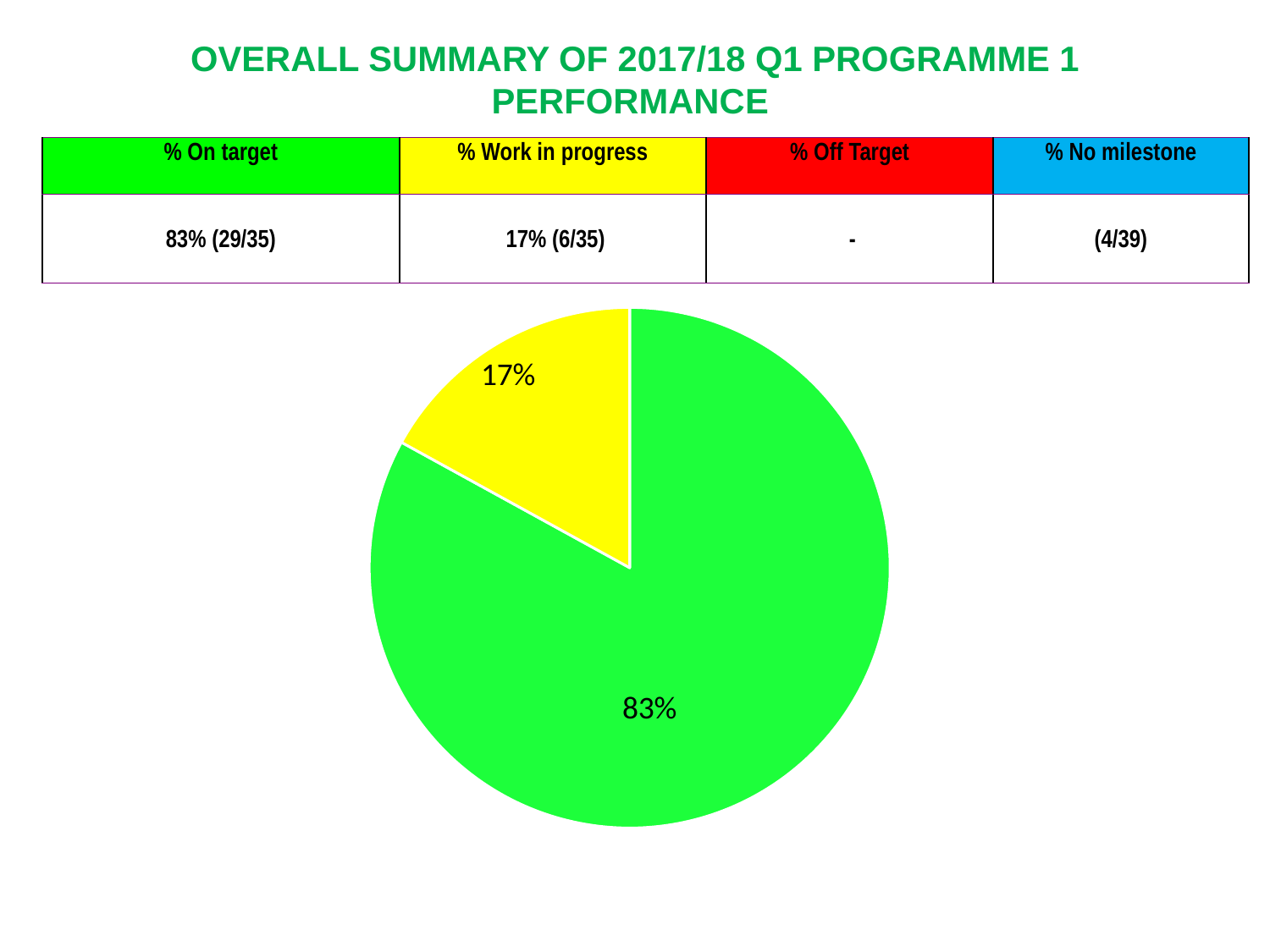
Which slice of the pie chart is the smallest? the yellow slice (17%) Using the colour key in the table above the pie chart, which category does the yellow slice represent? % Work in progress What kind of chart is shown on the slide? pie chart What is the difference in percentage points between the green slice and the yellow slice of the pie chart? 66 What share of the pie does the yellow slice represent? 17% What percentage is shown on the green slice of the pie chart? 83% Which is larger in the pie chart, the green slice or the yellow slice? the green slice Which slice of the pie chart is the largest? the green slice (83%) Using the colour key in the table above the pie chart, which category does the green slice represent? % On target How many slices does the pie chart have? 2 What percentage is shown on the yellow slice of the pie chart? 17% What is the total of the two percentages shown on the pie chart? 100%